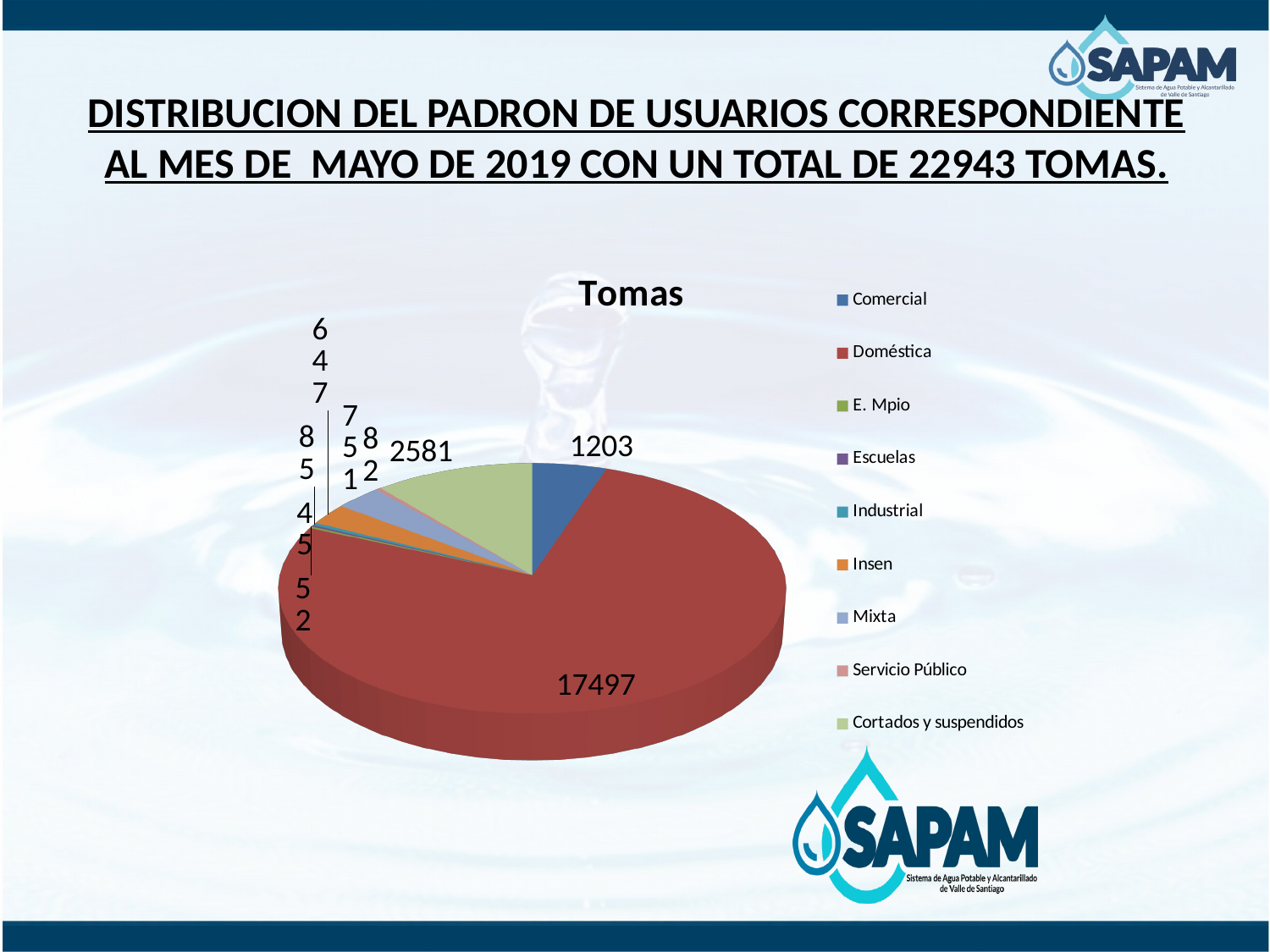
How many categories does the legend of the Tomas chart list? 9 Which category has the largest slice in the Tomas pie chart? Doméstica What kind of chart is shown on the slide? Pie chart What is the value for Doméstica in the Tomas pie chart? 17497 Which is larger in the Tomas chart, Comercial or Cortados y suspendidos? Cortados y suspendidos What is the difference between the Doméstica and Comercial values in the Tomas chart? 16294 What is the value for Comercial in the Tomas pie chart? 1203 What is the difference between the Cortados y suspendidos and Comercial values in the Tomas chart? 1378 What is the title of the chart on the slide? Tomas Which is larger in the Tomas chart, Doméstica or Cortados y suspendidos? Doméstica What colour represents Doméstica in the Tomas chart? Red What is the value for Cortados y suspendidos in the Tomas pie chart? 2581